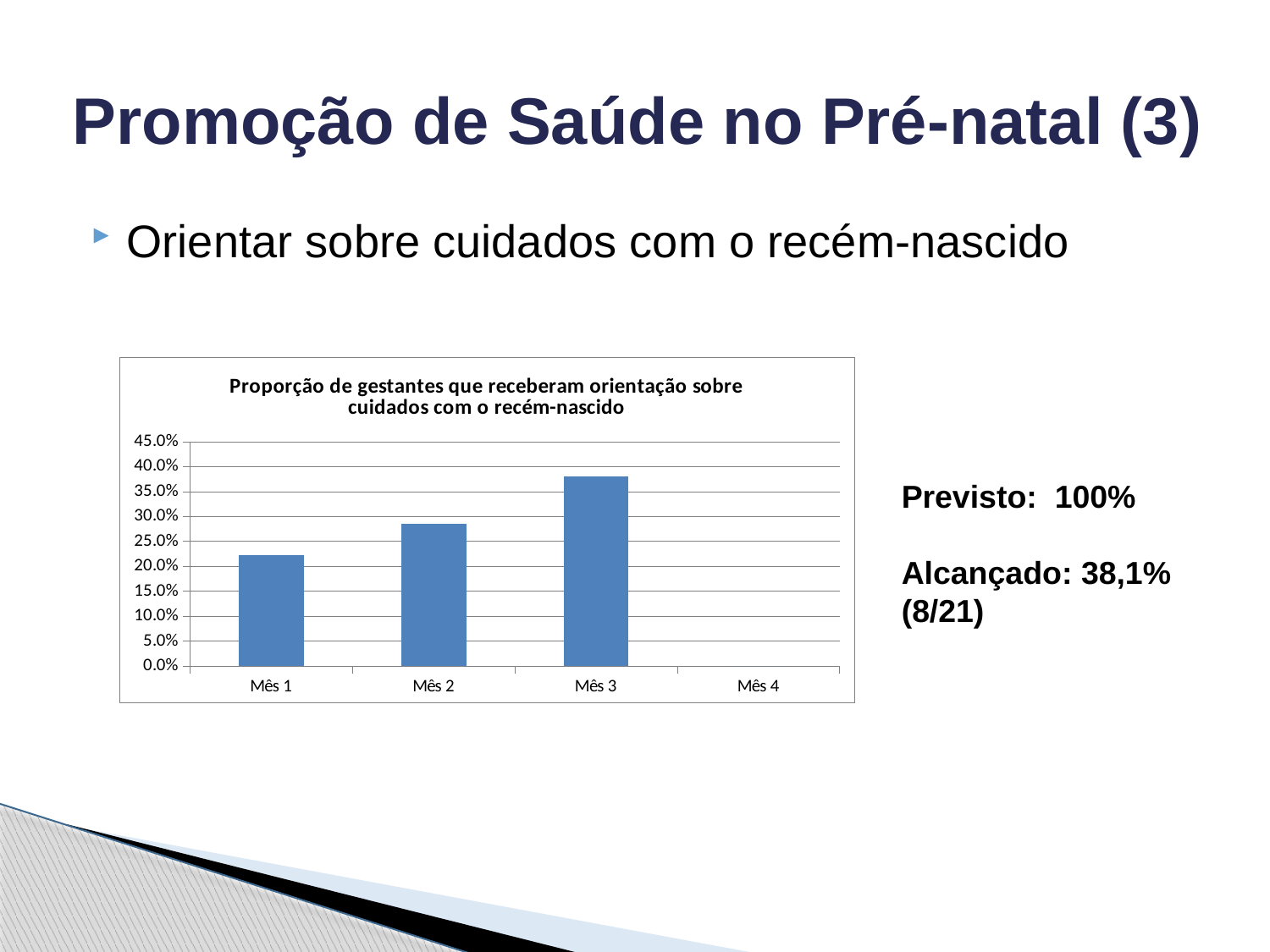
Is the value for Mês 3 greater or less than 40.0%? less Which is larger, the value for Mês 1 or the value for Mês 2? Mês 2 Which month has the tallest bar in the chart? Mês 3 What is the title of the chart? Proporção de gestantes que receberam orientação sobre cuidados com o recém-nascido Is the value for Mês 2 greater or less than 25.0%? greater How many categories are shown on the x axis of the chart? 4 Do the values rise or fall from Mês 1 to Mês 3? rise Which month has no visible bar in the chart? Mês 4 What kind of chart is shown on the slide? bar chart Is the value for Mês 3 greater or less than 35.0%? greater